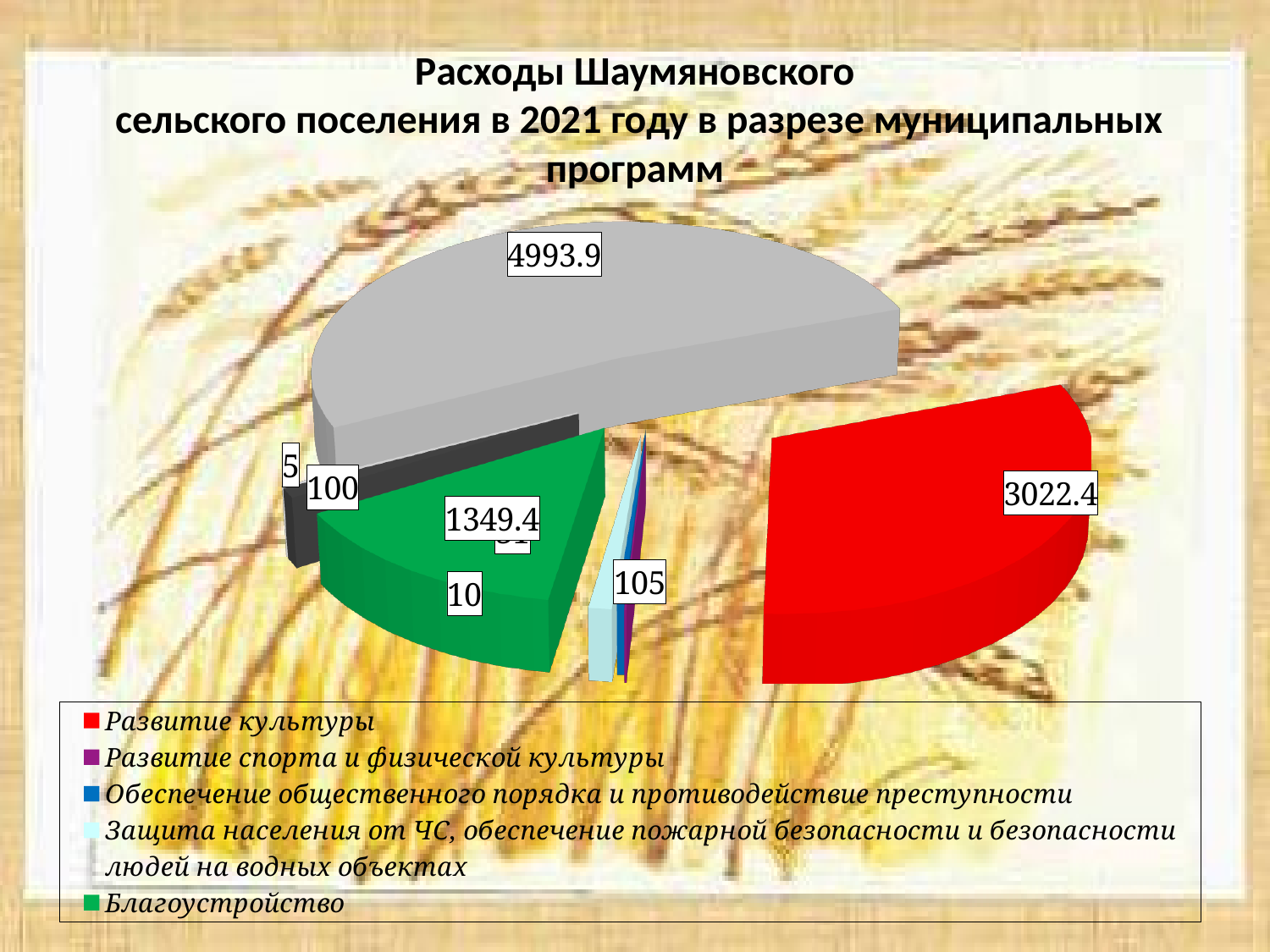
How many entries does the legend list? 5 What value is labeled on the dark grey slice? 100 What is the value shown for Благоустройство (the green slice)? 1349.4 What is the title of the chart? Расходы Шаумяновского сельского поселения в 2021 году в разрезе муниципальных программ Which colour represents Развитие культуры in the legend? red What is the difference between the values for Развитие культуры (3022.4) and Благоустройство (1349.4)? 1673 Which is larger, the value for Развитие культуры or the value for Благоустройство? Развитие культуры What value is labeled on the largest (light grey) slice of the pie? 4993.9 What kind of chart is shown on the slide? pie chart What value is labeled on the light blue slice (Защита населения от ЧС, обеспечение пожарной безопасности и безопасности людей на водных объектах)? 105 What is the value shown for Развитие культуры (the red slice)? 3022.4